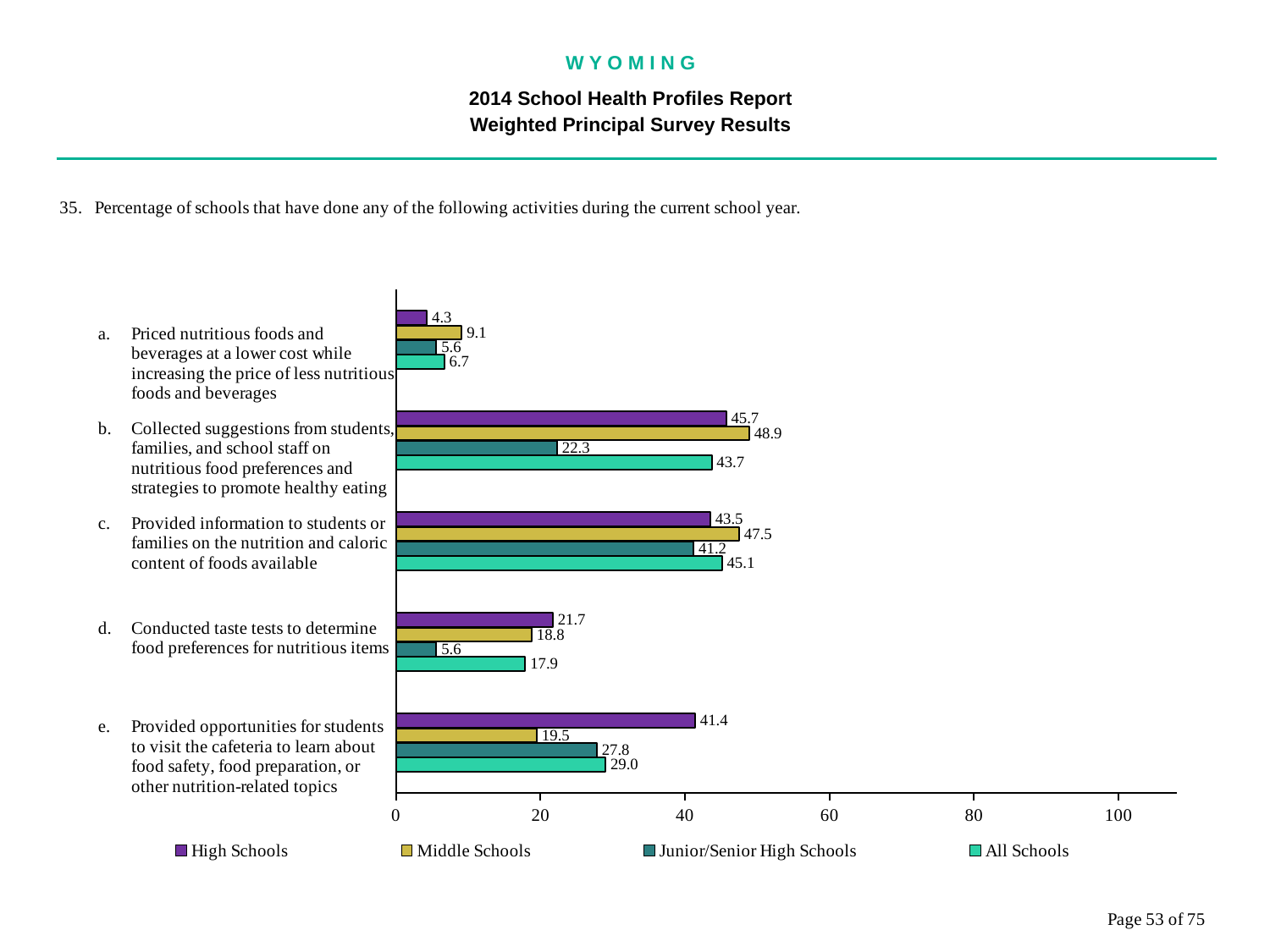
Which activity has the lowest value for All Schools? a. Priced nutritious foods and beverages at a lower cost while increasing the price of less nutritious foods and beverages What is the difference between the High Schools and Middle Schools values for activity e? 21.9 Is the value for Junior/Senior High Schools for activity e greater or less than 20? greater What is the value for Middle Schools for activity b (Collected suggestions from students, families, and school staff on nutritious food preferences and strategies to promote healthy eating)? 48.9 What is the value for Junior/Senior High Schools for activity d (Conducted taste tests to determine food preferences for nutritious items)? 5.6 What is the value for High Schools for activity e (Provided opportunities for students to visit the cafeteria to learn about food safety, food preparation, or other nutrition-related topics)? 41.4 How many series does the legend list? 4 Which activity has the highest value for Middle Schools? b. Collected suggestions from students, families, and school staff on nutritious food preferences and strategies to promote healthy eating How many activities (categories) are shown on the chart? 5 What is the value for All Schools for activity c (Provided information to students or families on the nutrition and caloric content of foods available)? 45.1 For activity b, which is larger: the value for High Schools or the value for Junior/Senior High Schools? High Schools What kind of chart is shown on the slide? Bar chart